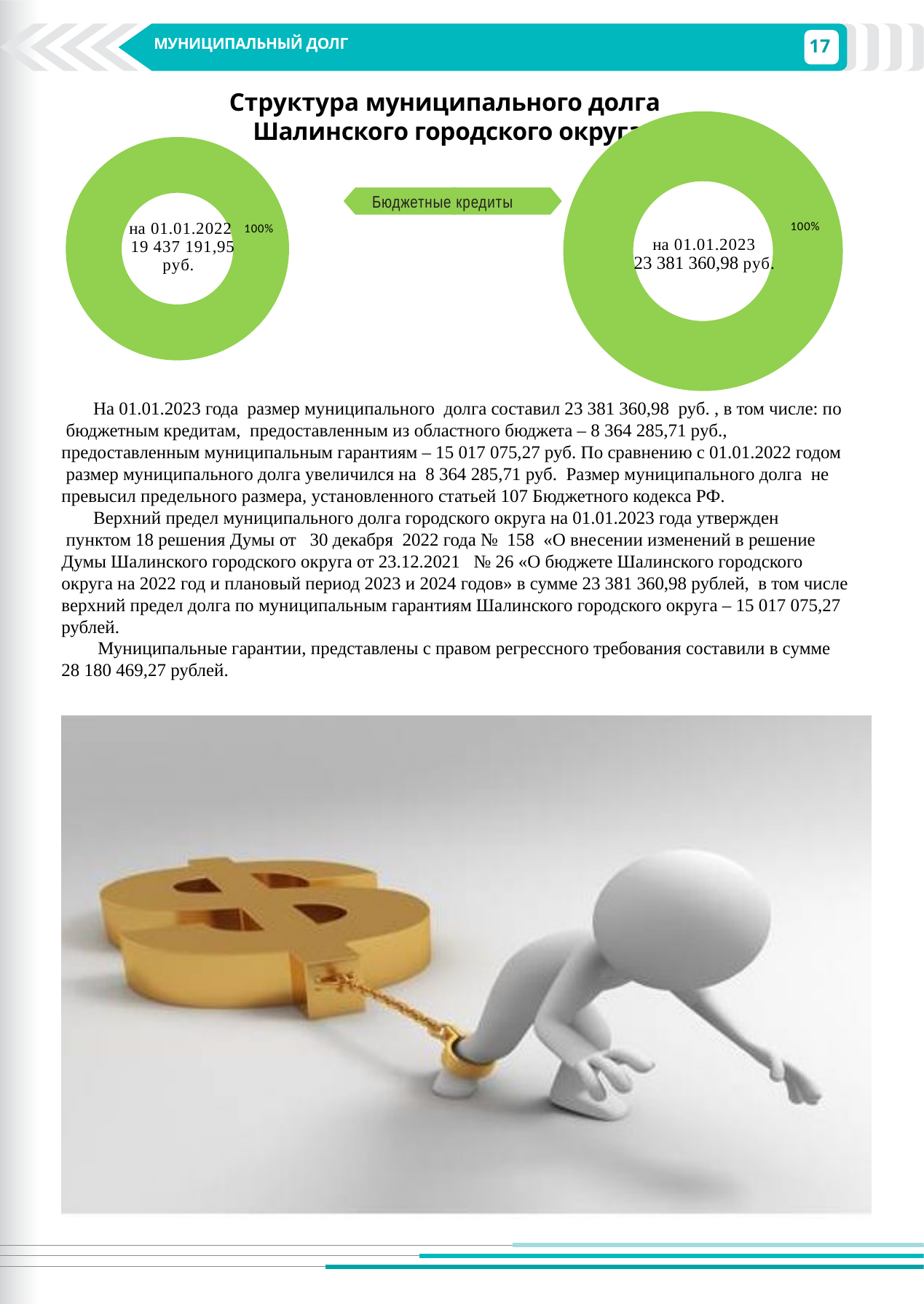
How many slices does the left chart (на 01.01.2022) contain? 1 How many slices does the right chart (на 01.01.2023) contain? 1 What is the legend entry shown between the two charts? Бюджетные кредиты In the left chart (на 01.01.2022), what share does the single slice show? 100% What amount is printed in the centre of the left chart for 01.01.2022? 19 437 191,95 руб. What amount is printed in the centre of the right chart for 01.01.2023? 23 381 360,98 руб. What kind of chart is the left chart labelled 'на 01.01.2022'? Donut (pie) chart Which chart shows the larger amount in its centre, the left one (01.01.2022) or the right one (01.01.2023)? The right one (01.01.2023) What is the title above the two charts? Структура муниципального долга Шалинского городского округа What kind of chart is the right chart labelled 'на 01.01.2023'? Donut (pie) chart In the right chart (на 01.01.2023), what share does the single slice show? 100%